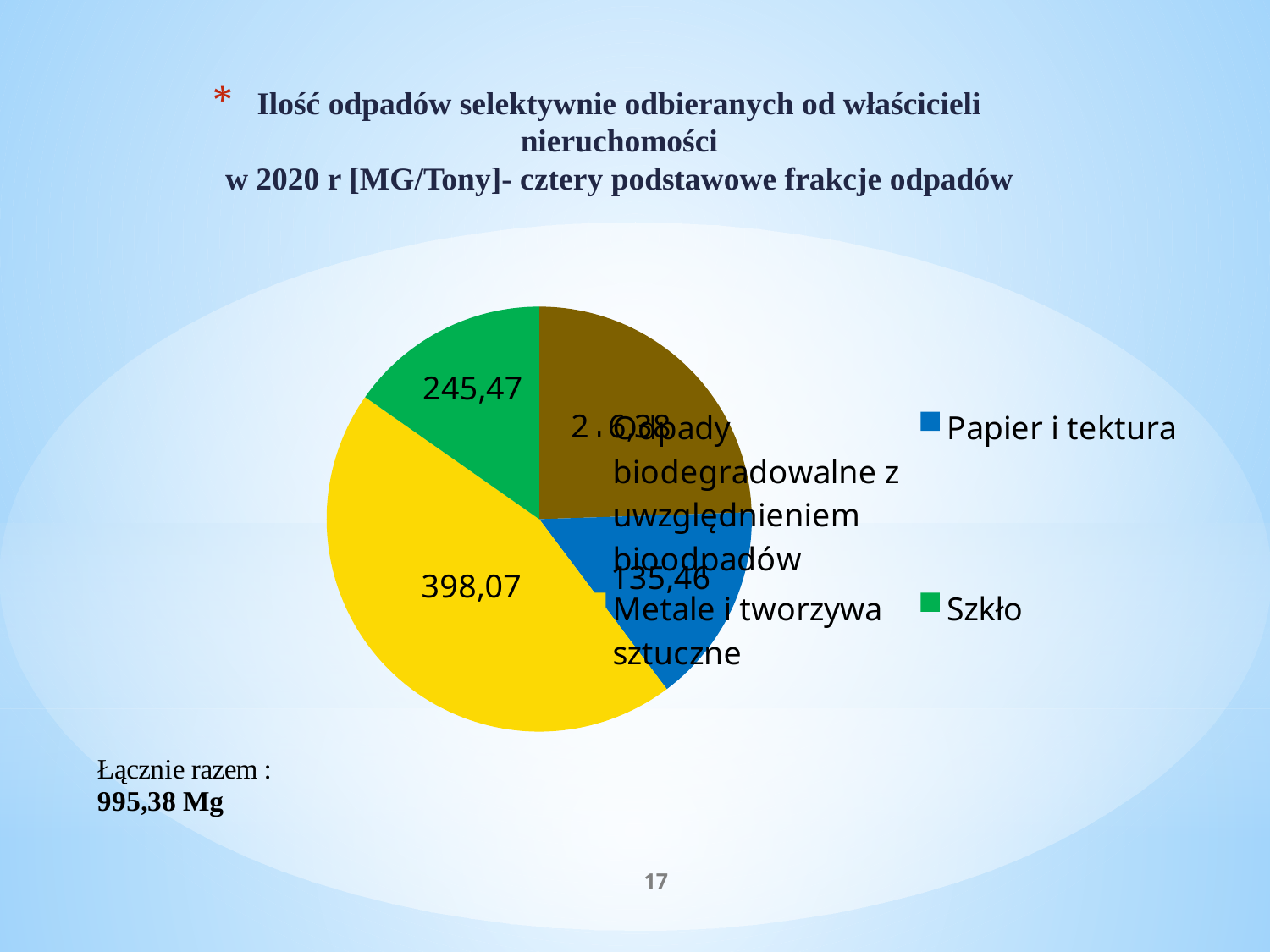
What is the difference between the values for Szkło and Papier i tektura? 110,01 What total amount (Łącznie razem) is stated on the slide? 995,38 Mg What type of chart is shown on the slide? pie chart Which category has the smallest slice in the pie chart? Papier i tektura Which is larger, the value for Szkło or the value for Papier i tektura? Szkło How many entries does the legend list? 4 How many slices does the pie chart have? 4 What is the difference between the yellow slice (398,07) and the Szkło slice? 152,60 What is the value shown for Szkło in the pie chart? 245,47 What is the value shown for Papier i tektura in the pie chart? 135,46 What colour is the Szkło slice in the pie chart? green What is the value of the largest slice (the yellow one) in the pie chart? 398,07